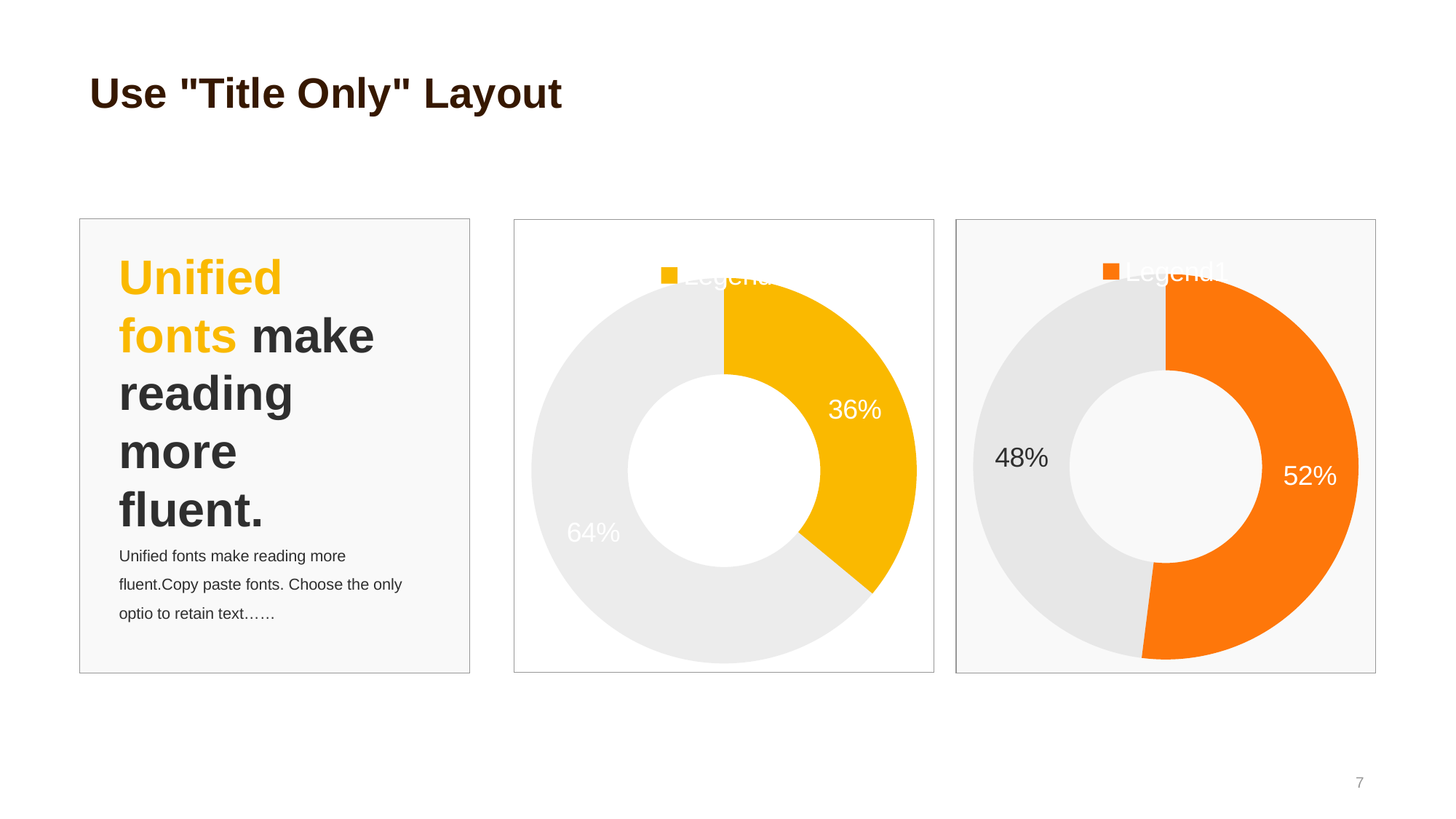
How many slices does the middle doughnut chart have? 2 In the middle doughnut chart, which slice is larger, the yellow one or the grey one? the grey one In the middle doughnut chart, what is the difference between the grey slice and the yellow slice? 28% In the right doughnut chart, what percentage is shown on the orange slice? 52% In the middle doughnut chart, what percentage is shown on the yellow slice? 36% In the right doughnut chart, what percentage is shown on the grey slice? 48% What legend entry is shown above the right doughnut chart? Legend1 What kind of chart is the right chart on the slide? doughnut chart In the right doughnut chart, what is the difference between the orange slice and the grey slice? 4% In the right doughnut chart, which slice is larger, the orange one or the grey one? the orange one How many slices does the right doughnut chart have? 2 In the middle doughnut chart, what percentage is shown on the grey slice? 64%